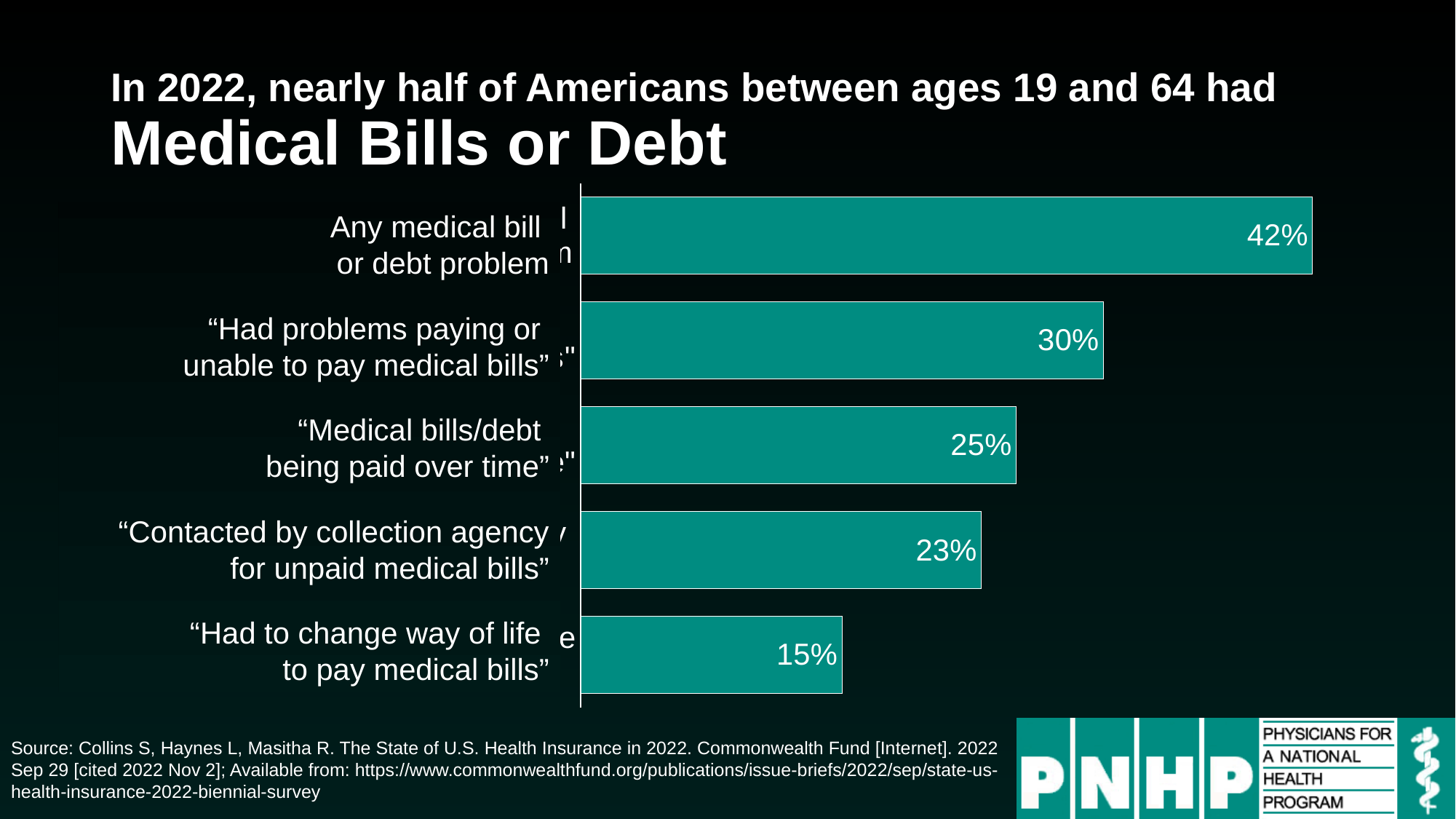
What is the difference between "Had problems paying or unable to pay medical bills" and "Contacted by collection agency for unpaid medical bills"? 7% Which category has the lowest value? Had to change way of life to pay medical bills What is the value for "Medical bills/debt being paid over time"? 25% What kind of chart is shown on the slide? Bar chart What percentage of Americans ages 19 to 64 had any medical bill or debt problem in 2022? 42% What is the difference between "Any medical bill or debt problem" and "Had to change way of life to pay medical bills"? 27% What is the value for "Contacted by collection agency for unpaid medical bills"? 23% Which category has the highest value? Any medical bill or debt problem What is the value for "Had to change way of life to pay medical bills"? 15% How many categories are shown in the chart? 5 Which is larger: "Medical bills/debt being paid over time" or "Contacted by collection agency for unpaid medical bills"? Medical bills/debt being paid over time What is the value for "Had problems paying or unable to pay medical bills"? 30%